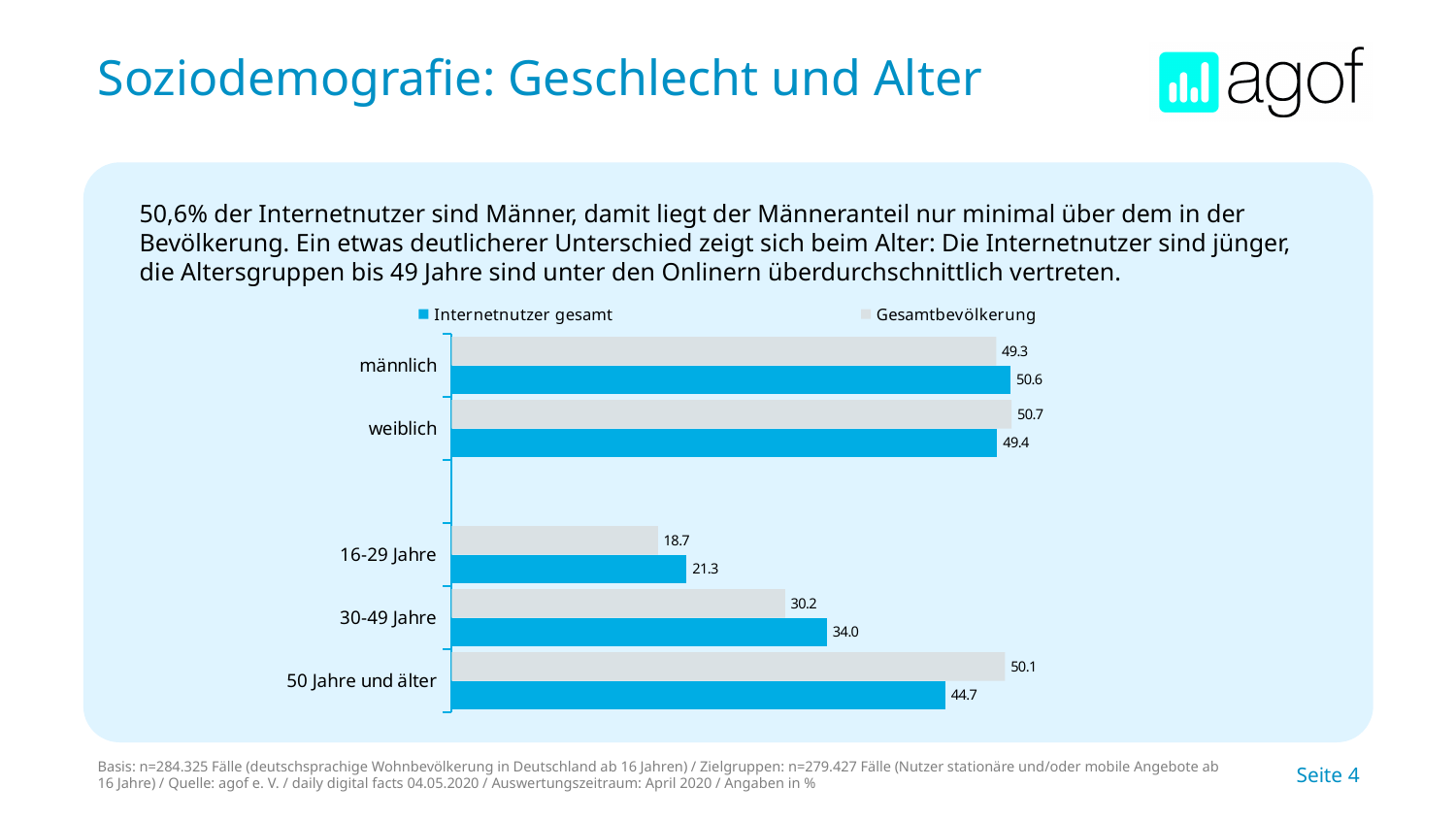
Which colour represents the Gesamtbevölkerung series? Grey How many categories are shown on the chart? 5 Which age group has the highest value for Internetnutzer gesamt? 50 Jahre und älter What is the value for Gesamtbevölkerung in the 30-49 Jahre category? 30.2 What is the difference between Gesamtbevölkerung and Internetnutzer gesamt in the 50 Jahre und älter category? 5.4 How many series does the legend list? 2 What kind of chart is shown on the slide? Bar chart What is the value for Internetnutzer gesamt in the 16-29 Jahre category? 21.3 Which age group has the lowest value for Gesamtbevölkerung? 16-29 Jahre What is the value for Gesamtbevölkerung in the weiblich category? 50.7 In the 30-49 Jahre category, which is larger: Internetnutzer gesamt or Gesamtbevölkerung? Internetnutzer gesamt What is the value for Internetnutzer gesamt in the männlich category? 50.6